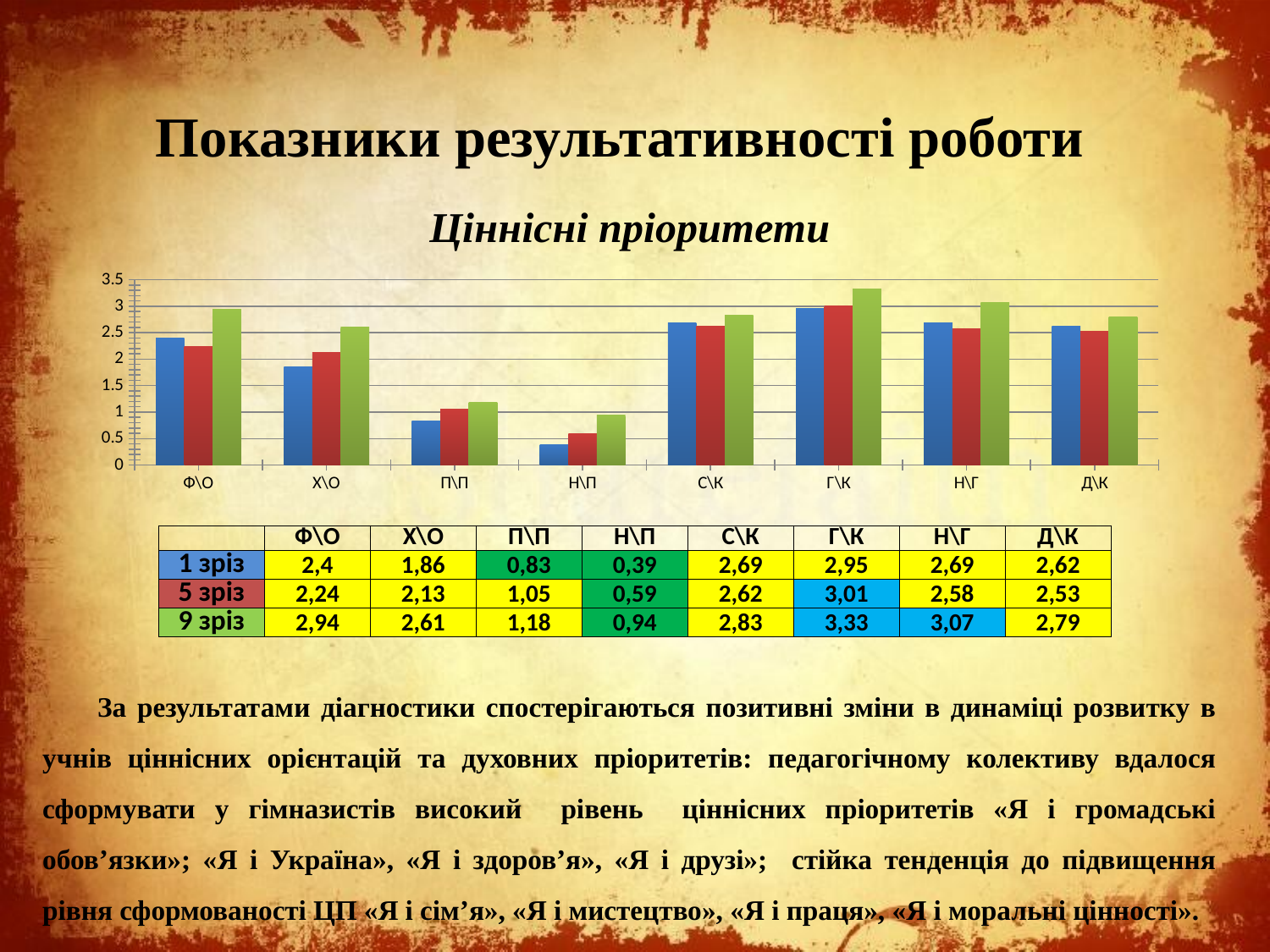
What is the difference between the 9 зріз and 1 зріз values for Г\К? 0,38 What is the difference between the 9 зріз and 1 зріз values for Ф\О? 0,54 What is the value for Г\К in the 9 зріз series? 3,33 What is the value for Н\П in the 1 зріз series? 0,39 Which category has the lowest value in the 5 зріз series? Н\П What is the value for Х\О in the 5 зріз series? 2,13 For С\К, which is larger: the 1 зріз value or the 5 зріз value? 1 зріз How many series does the chart show? 3 Which category has the highest value in the 9 зріз series? Г\К What kind of chart is shown on the slide? bar chart Is the 9 зріз value for Г\К greater or less than 3? greater How many categories are shown on the x axis of the chart? 8